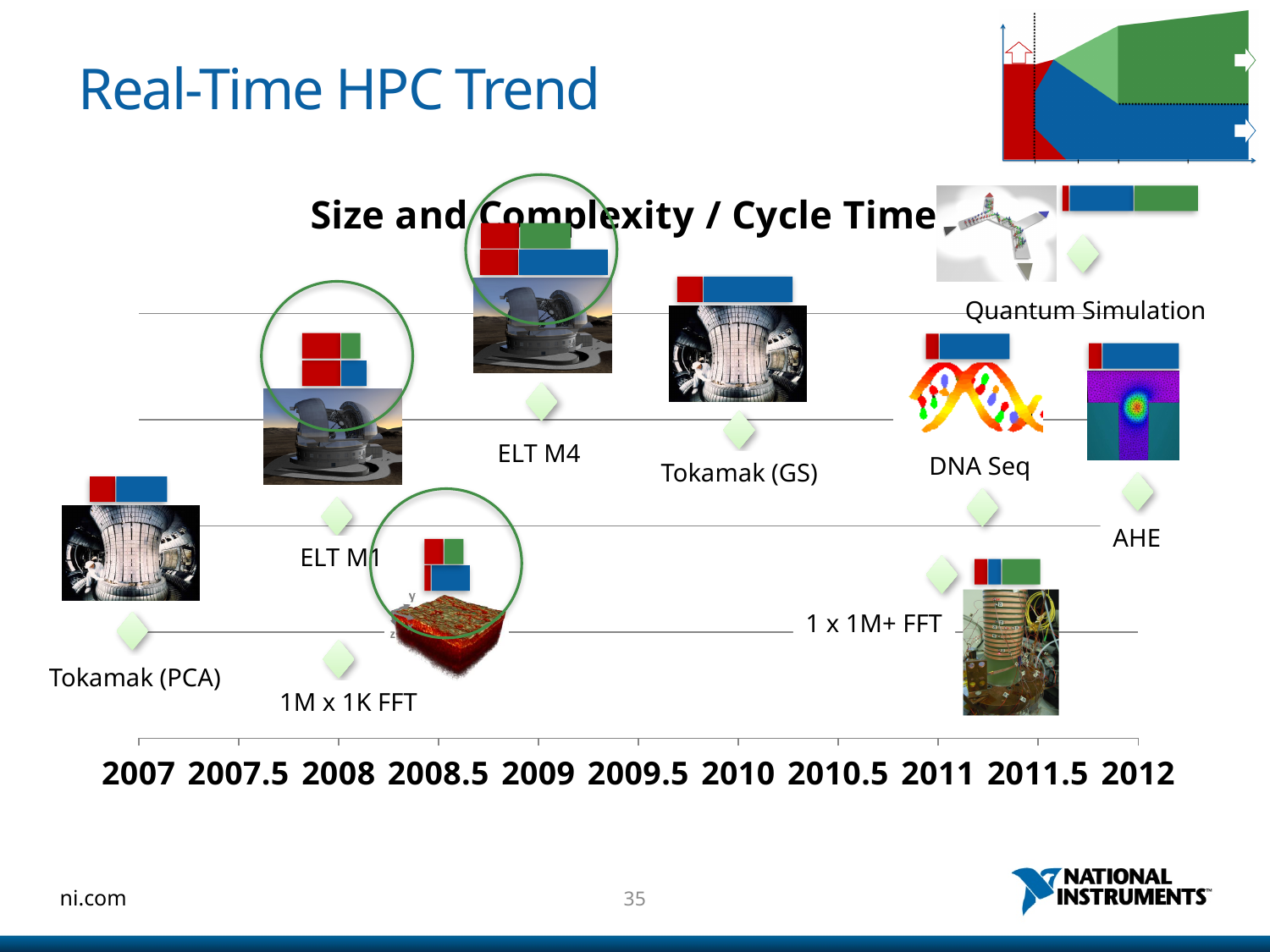
Which is plotted higher on the chart, ELT M1 or ELT M4? ELT M4 In which year is the AHE point plotted? 2012 In which year is the Tokamak (GS) point plotted? 2010 What is the title of the chart? Size and Complexity / Cycle Time What kind of chart is shown on the slide? scatter chart In which year is the ELT M4 point plotted? 2009 Do the plotted points generally rise or fall as the years increase along the x axis? rise Which is plotted higher on the chart, Tokamak (PCA) or Tokamak (GS)? Tokamak (GS) Which data point is plotted highest on the chart? Quantum Simulation How many labeled data points are plotted on the chart? 9 What is the first year shown on the x axis? 2007 In which year is the Tokamak (PCA) point plotted? 2007